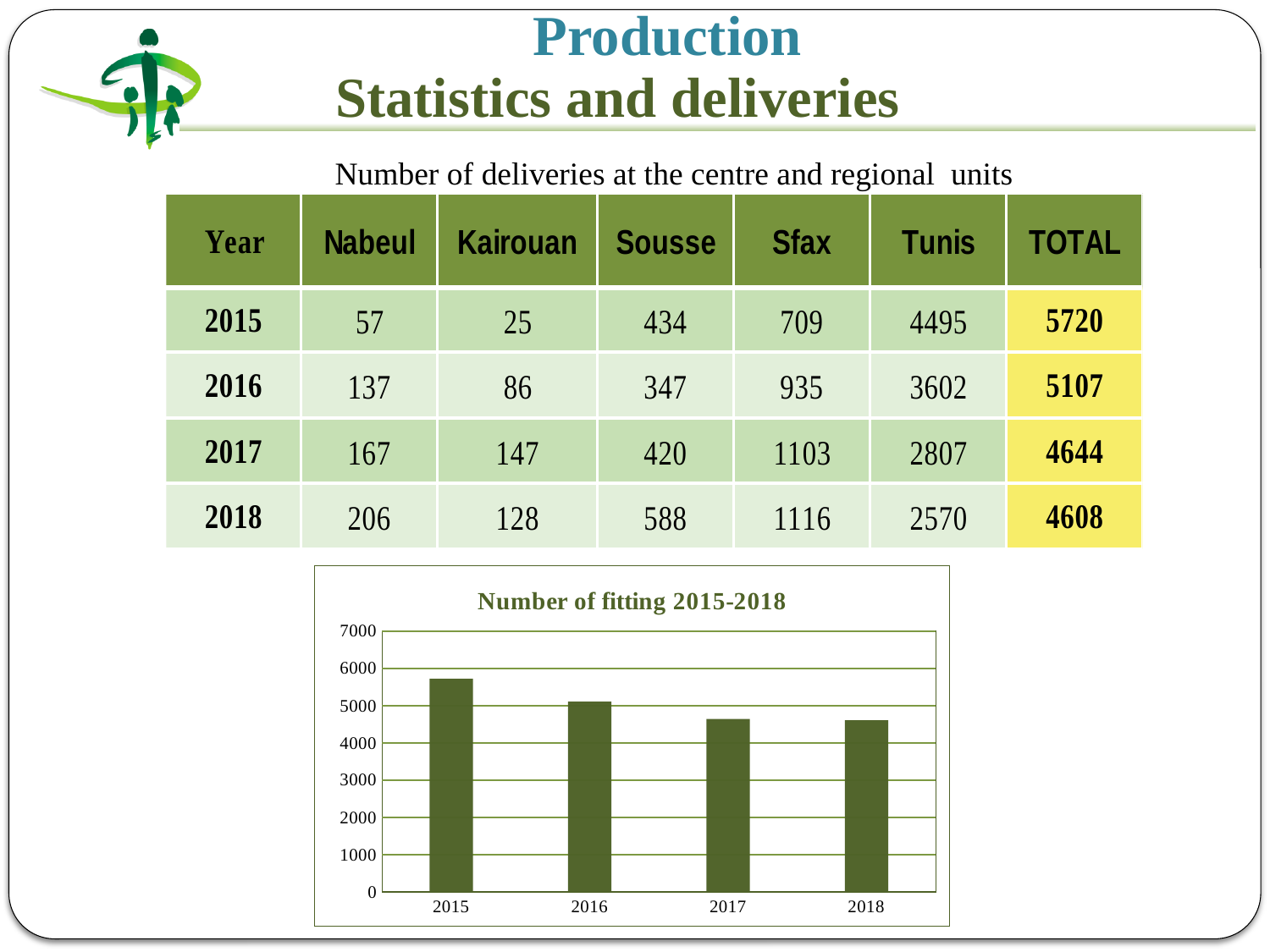
Is the bar for 2015 greater or less than 5000? greater Is the bar for 2017 greater or less than 4000? greater Is the bar for 2018 greater or less than 5000? less Which year has the tallest bar in the chart? 2015 What is the highest value shown on the chart's vertical axis? 7000 What is the title of the chart? Number of fitting 2015-2018 Do the bar values rise or fall from 2015 to 2018? fall Which year has the shortest bar in the chart? 2018 What kind of chart is shown on the slide? bar chart How many bars does the chart show? 4 Which bar is taller, 2015 or 2016? 2015